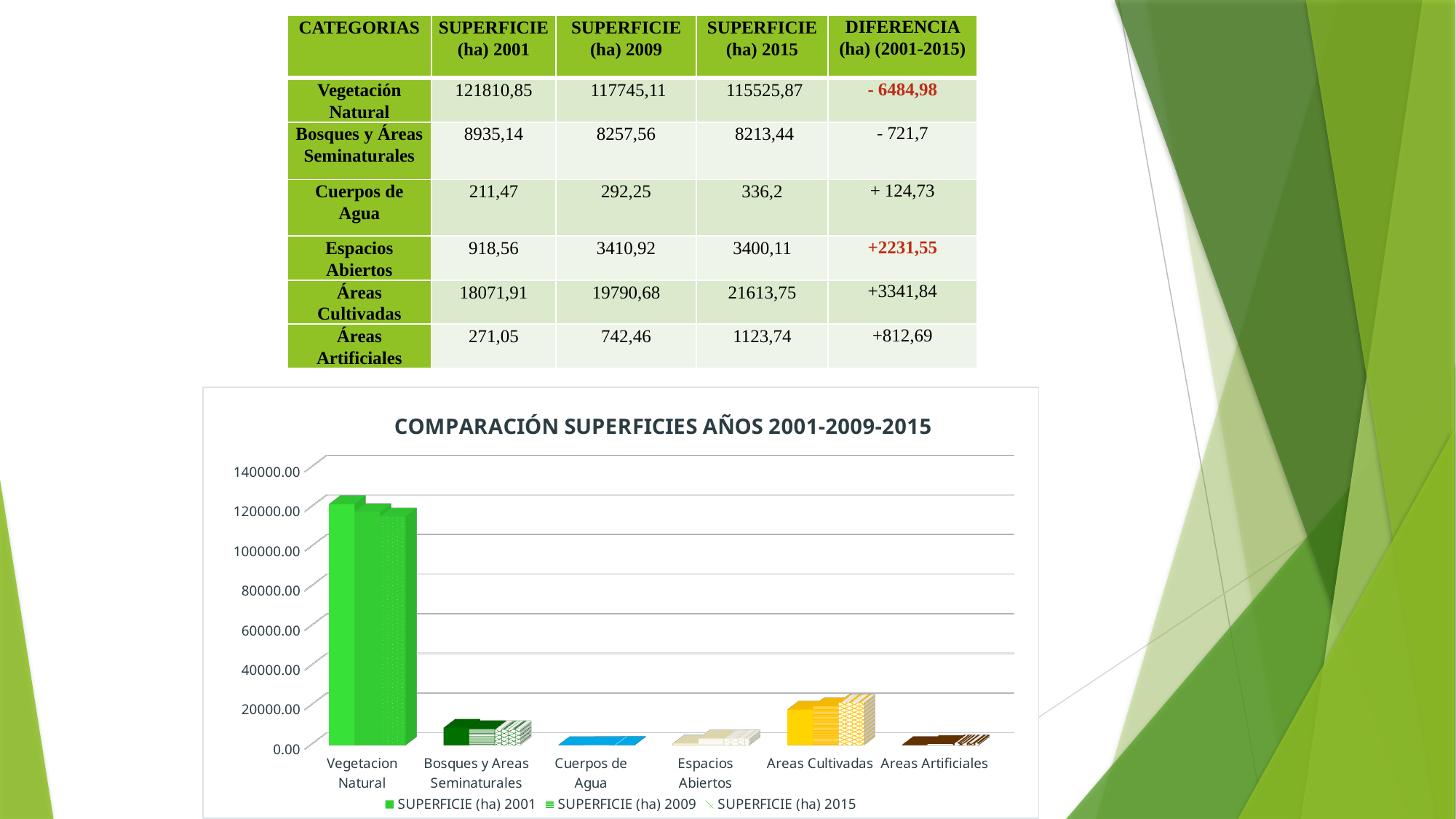
What kind of chart is shown on the slide? bar chart Is the value for Areas Cultivadas in the SUPERFICIE (ha) 2015 series greater or less than 40000.00? less Is the value for Vegetacion Natural in the SUPERFICIE (ha) 2001 series greater or less than 100000.00? greater Which is larger in the SUPERFICIE (ha) 2015 series: Areas Cultivadas or Bosques y Areas Seminaturales? Areas Cultivadas Do the bars for Vegetacion Natural rise or fall from the 2001 series to the 2015 series? fall According to the table, what is the SUPERFICIE (ha) 2001 value for Vegetación Natural? 121810,85 According to the table, what is the DIFERENCIA (ha) (2001-2015) for Espacios Abiertos? +2231,55 Which category has the highest bars in the chart? Vegetacion Natural How many series does the chart legend list? 3 What is the title of the chart? COMPARACIÓN SUPERFICIES AÑOS 2001-2009-2015 How many categories are shown on the x axis of the chart? 6 According to the table, by how much did Áreas Cultivadas change between 2001 and 2015? +3341,84